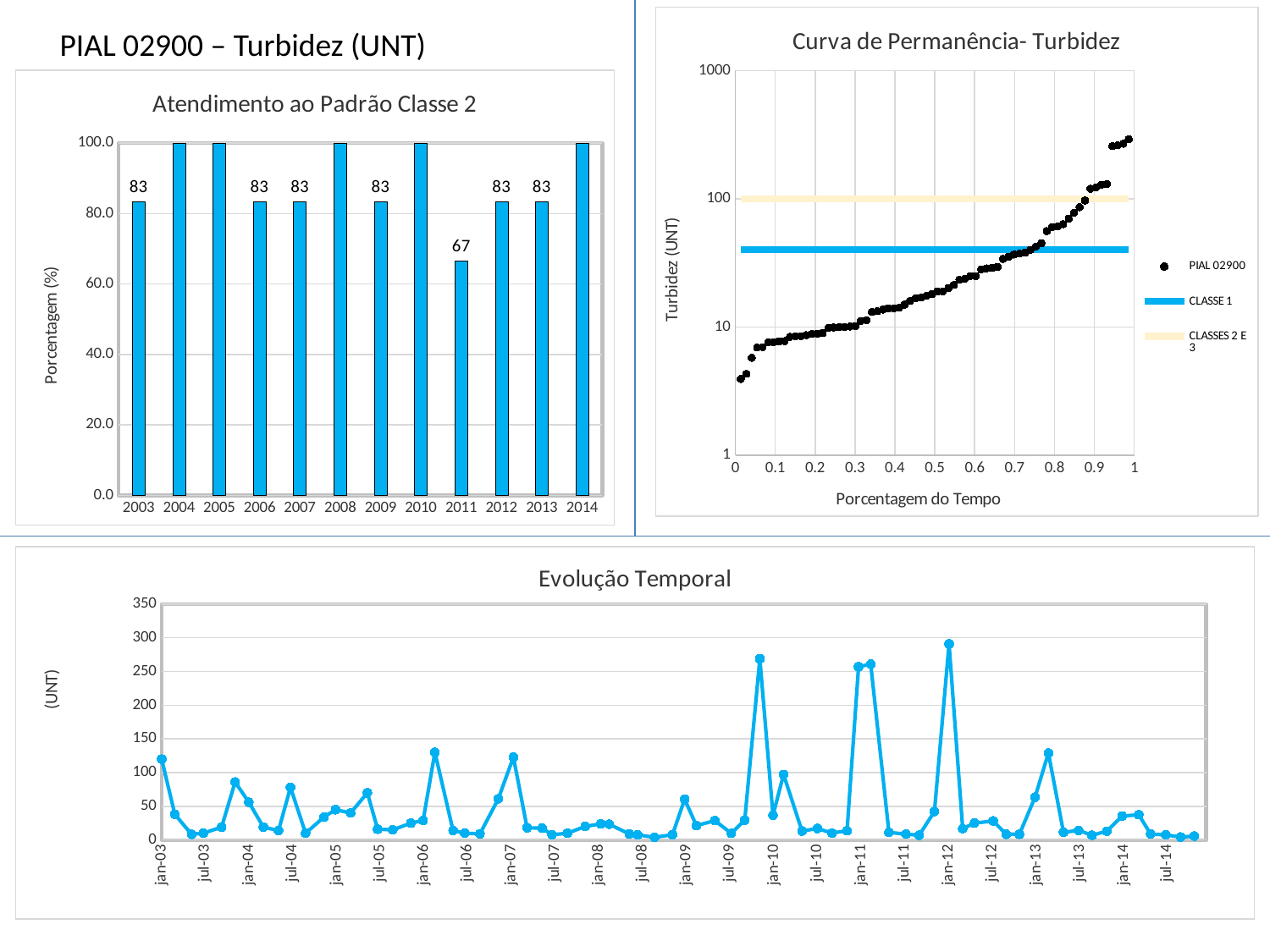
What is the y-axis title of the 'Curva de Permanência- Turbidez' chart? Turbidez (UNT) In the 'Atendimento ao Padrão Classe 2' chart, what is the value for 2011? 67 What kind of chart is 'Atendimento ao Padrão Classe 2'? bar chart What kind of chart is 'Evolução Temporal'? line chart In the 'Atendimento ao Padrão Classe 2' chart, what is the difference between the values for 2003 and 2011? 16 In the 'Atendimento ao Padrão Classe 2' chart, which year has the lowest value? 2011 In the 'Atendimento ao Padrão Classe 2' chart, is the value for 2004 greater or less than 80? greater How many series does the legend of the 'Curva de Permanência- Turbidez' chart list? 3 In the 'Atendimento ao Padrão Classe 2' chart, which is larger, the value for 2012 or the value for 2011? 2012 In the 'Atendimento ao Padrão Classe 2' chart, what is the value for 2003? 83 In the 'Atendimento ao Padrão Classe 2' chart, how many years are shown on the x axis? 12 In the 'Evolução Temporal' chart, is the value at jan-12 greater or less than 250? greater